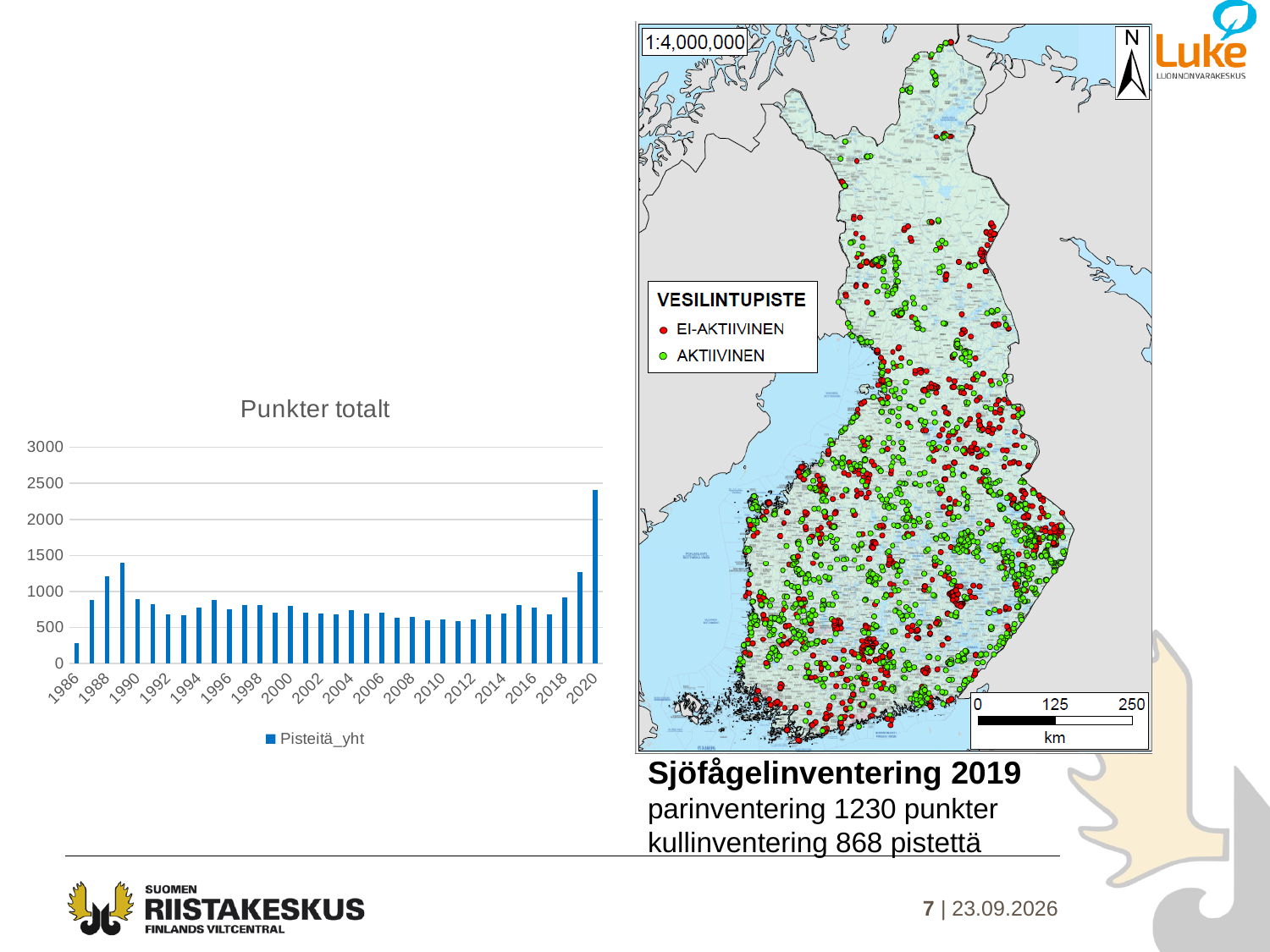
In the "Punkter totalt" chart, which year has the highest value? 2020 In the "Punkter totalt" chart, is the value for 2010 greater or less than 1000? less In the "Punkter totalt" chart, which year has the lowest value? 1986 In the "Punkter totalt" chart, do the values generally rise or fall from 2010 to 2020? rise In the "Punkter totalt" chart, which year has the larger value, 1988 or 1989? 1989 In the "Punkter totalt" chart, is the value for 2020 greater or less than 2000? greater In the "Punkter totalt" chart, is the value for 1989 greater or less than 1000? greater How many series does the legend of the "Punkter totalt" chart list? 1 What is the title of the chart on the left of the slide? Punkter totalt What is the name of the series shown in the legend of the "Punkter totalt" chart? Pisteitä_yht What kind of chart is "Punkter totalt"? bar chart